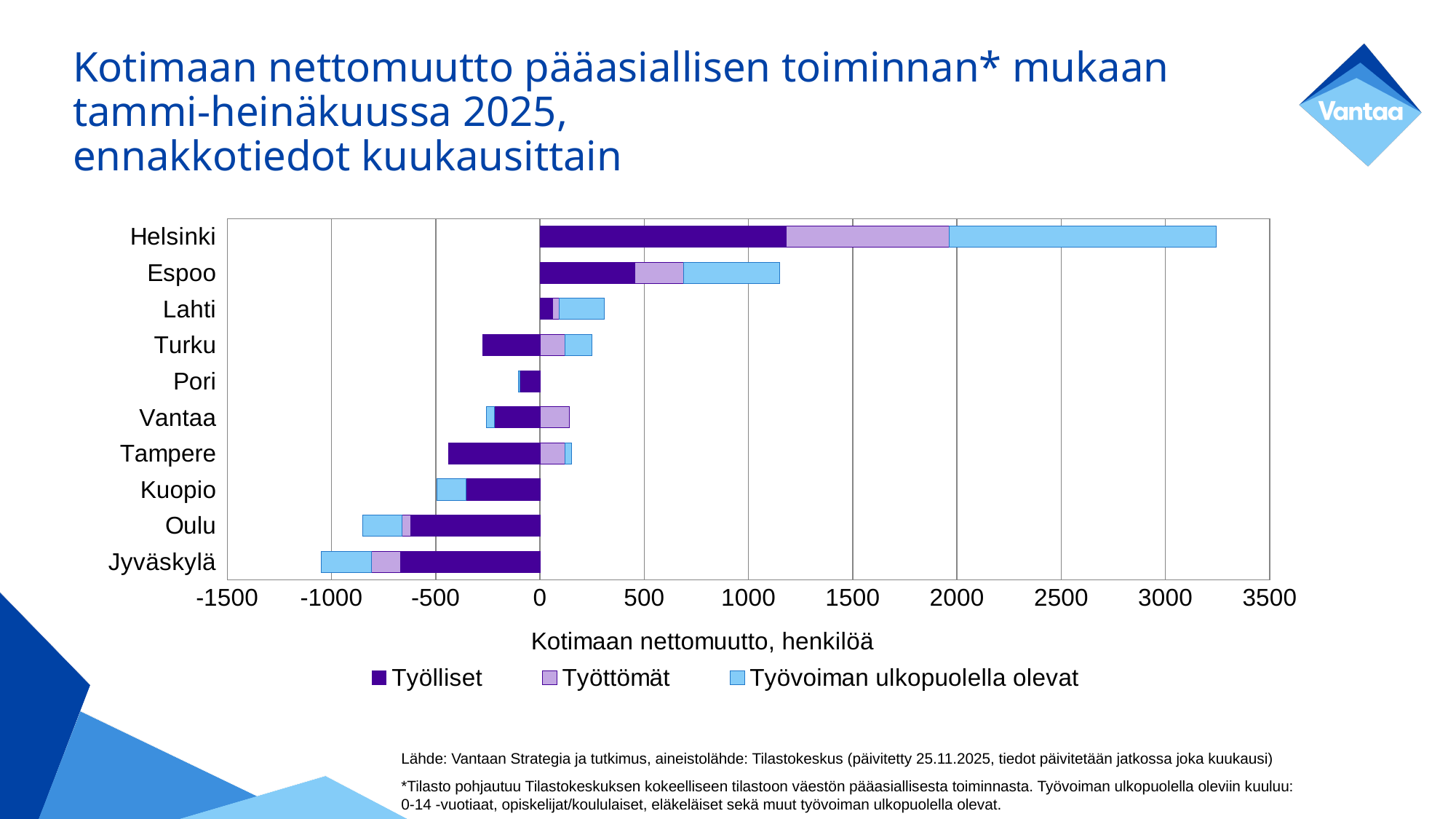
Which city has the larger Työvoiman ulkopuolella olevat value, Helsinki or Espoo? Helsinki Is the Työlliset value for Helsinki greater or less than 1000? greater Is the Työlliset value for Jyväskylä greater or less than -500? less What is the title of the horizontal axis of the chart? Kotimaan nettomuutto, henkilöä How many cities are listed on the vertical axis of the chart? 10 Which city has the larger Työlliset value, Espoo or Lahti? Espoo What kind of chart is shown on the slide? Stacked bar chart How many series does the chart legend list? 3 Is the total stacked bar for Helsinki greater or less than 3000? greater Which city has the largest Työlliset (employed) net migration value? Helsinki Which city's stacked bar extends furthest into negative values? Jyväskylä